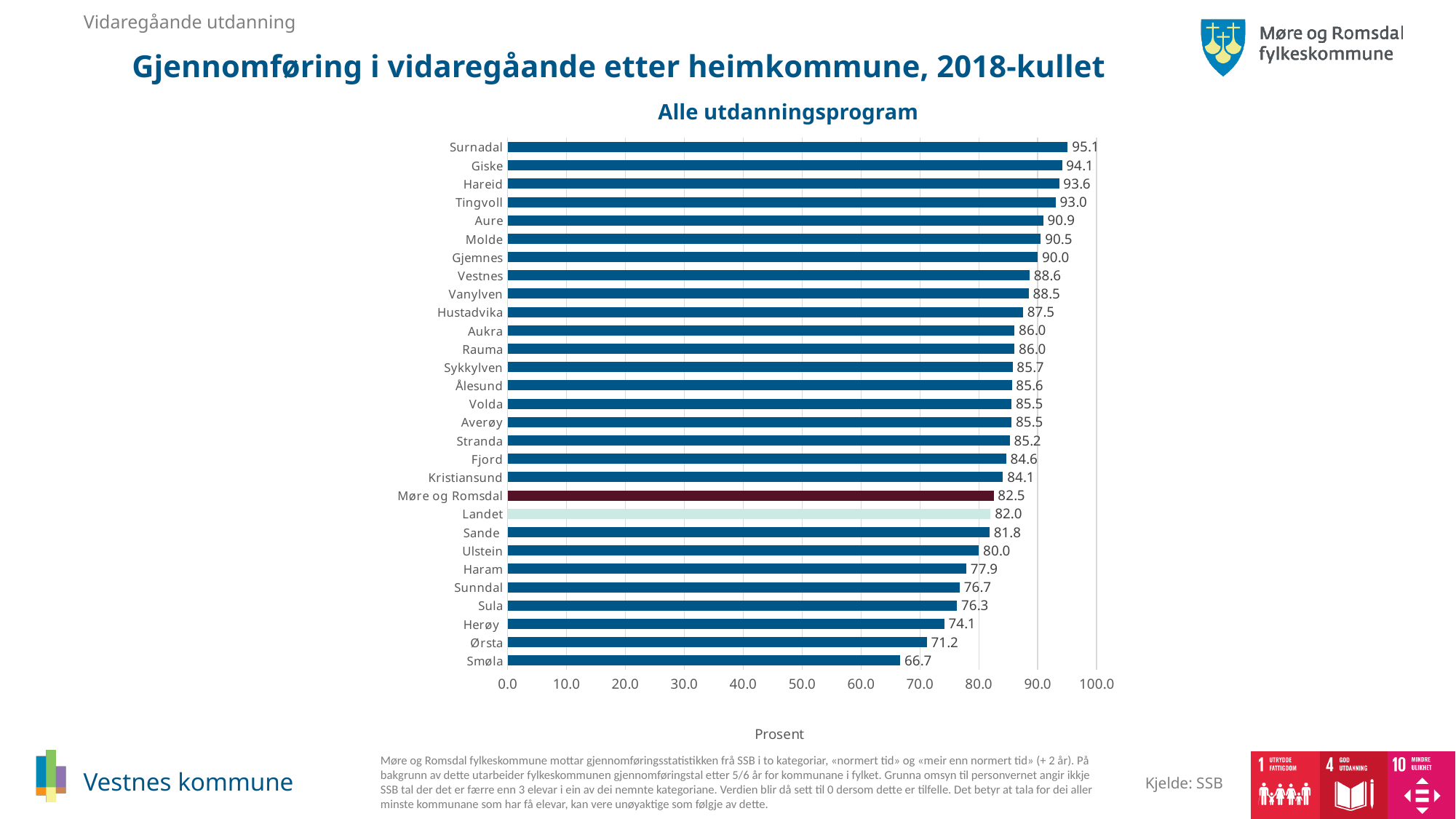
What is the value for Landet? 82.0 Which category has the highest value? Surnadal What kind of chart is shown on the slide? bar chart What is the difference between the values for Vestnes and Landet? 6.6 What is the title of the chart? Alle utdanningsprogram What is the value for Vestnes? 88.6 How many categories are shown on the chart? 29 Which is larger, the value for Molde or the value for Ålesund? Molde What is the value for Møre og Romsdal? 82.5 What is the difference between the values for Surnadal and Smøla? 28.4 Is the value for Ørsta greater or less than 80.0? less Which category has the lowest value? Smøla